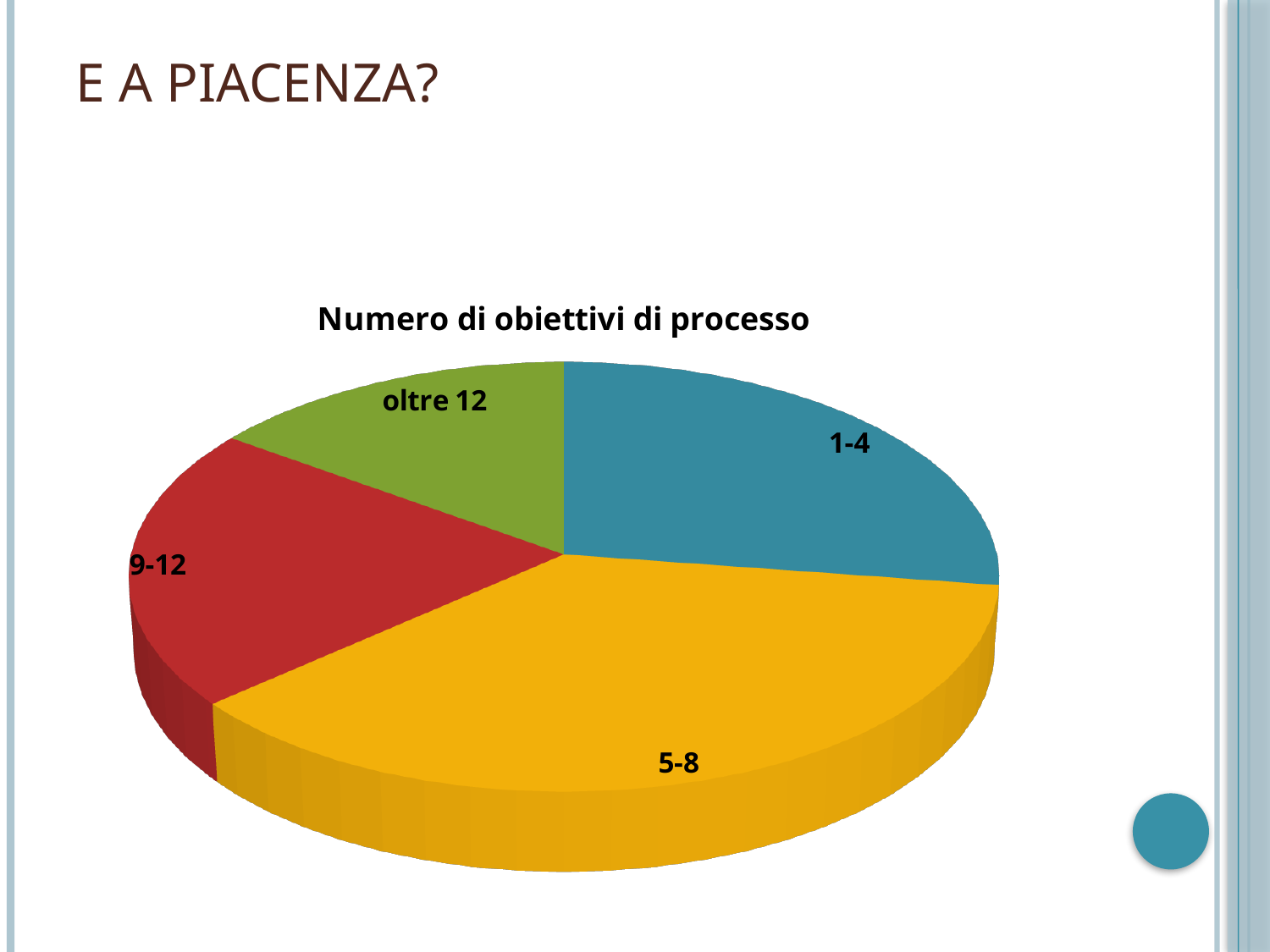
What colour is the slice for 5-8? yellow Which category has the smallest slice of the pie? oltre 12 What kind of chart is shown on the slide? pie chart What is the title of the chart? Numero di obiettivi di processo How many slices does the pie chart have? 4 Which slice is larger, 5-8 or 1-4? 5-8 Which slice is larger, 5-8 or 9-12? 5-8 Which slice is larger, 1-4 or oltre 12? 1-4 Which category has the largest slice of the pie? 5-8